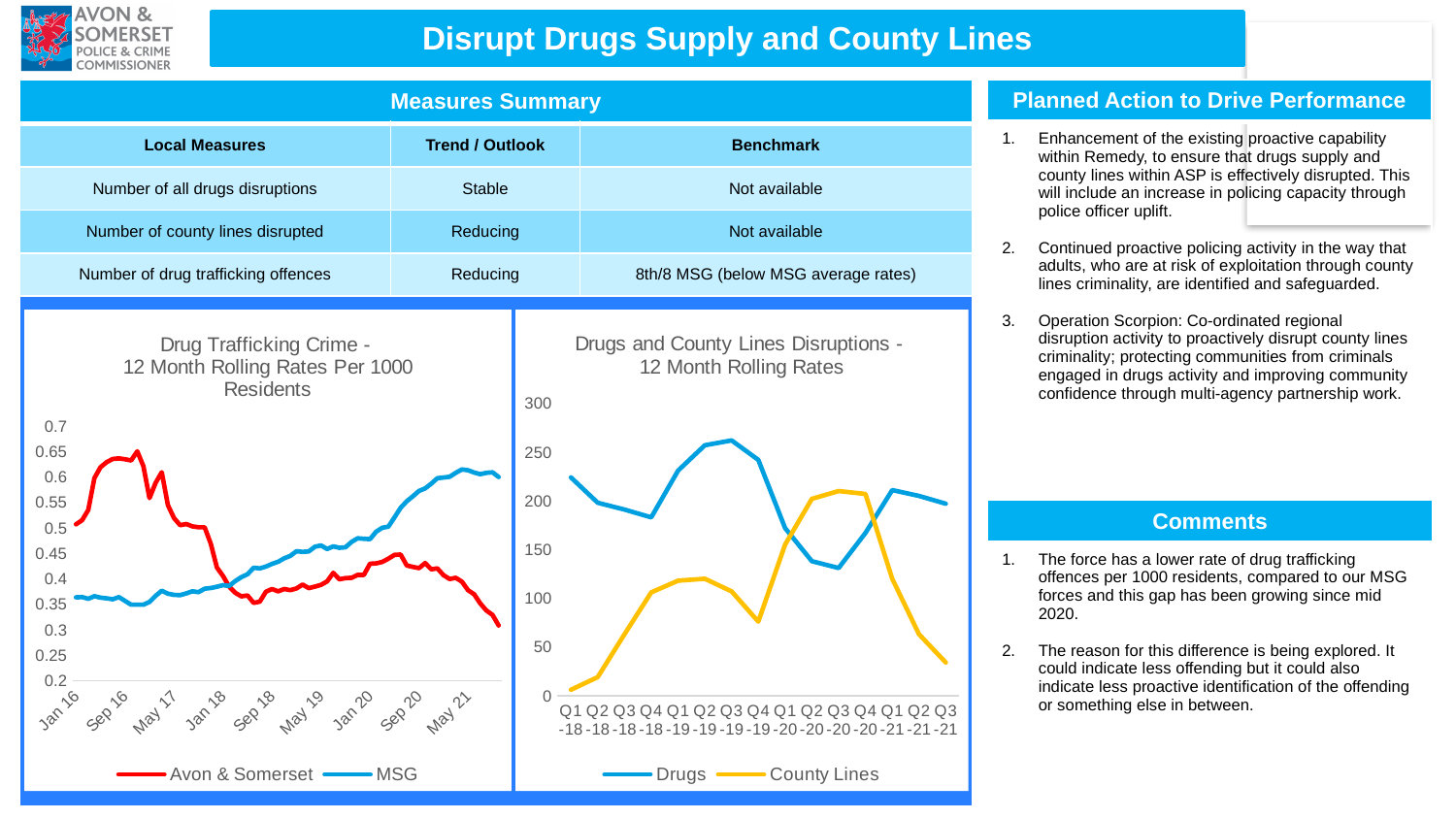
In the 'Drugs and County Lines Disruptions' chart, which series is higher at Q3-21, Drugs or County Lines? Drugs How many series does the legend of the 'Drugs and County Lines Disruptions - 12 Month Rolling Rates' chart list? 2 In the 'Drug Trafficking Crime' chart, which series is drawn in red? Avon & Somerset In the 'Drugs and County Lines Disruptions' chart, which series is drawn in yellow? County Lines How many quarters are shown on the x axis of the 'Drugs and County Lines Disruptions' chart? 15 In the 'Drugs and County Lines Disruptions' chart, is the County Lines value at Q1-18 greater or less than 50? less In the 'Drugs and County Lines Disruptions' chart, is the Drugs value at Q3-19 greater or less than 250? greater What kind of chart is the 'Drug Trafficking Crime - 12 Month Rolling Rates Per 1000 Residents' chart? Line chart In the 'Drug Trafficking Crime' chart, which series is higher at May 21, Avon & Somerset or MSG? MSG In the 'Drug Trafficking Crime' chart, is the Avon & Somerset value at Sep 16 greater or less than 0.6? greater In the 'Drug Trafficking Crime' chart, does the MSG series generally rise or fall from Jan 18 to May 21? Rise